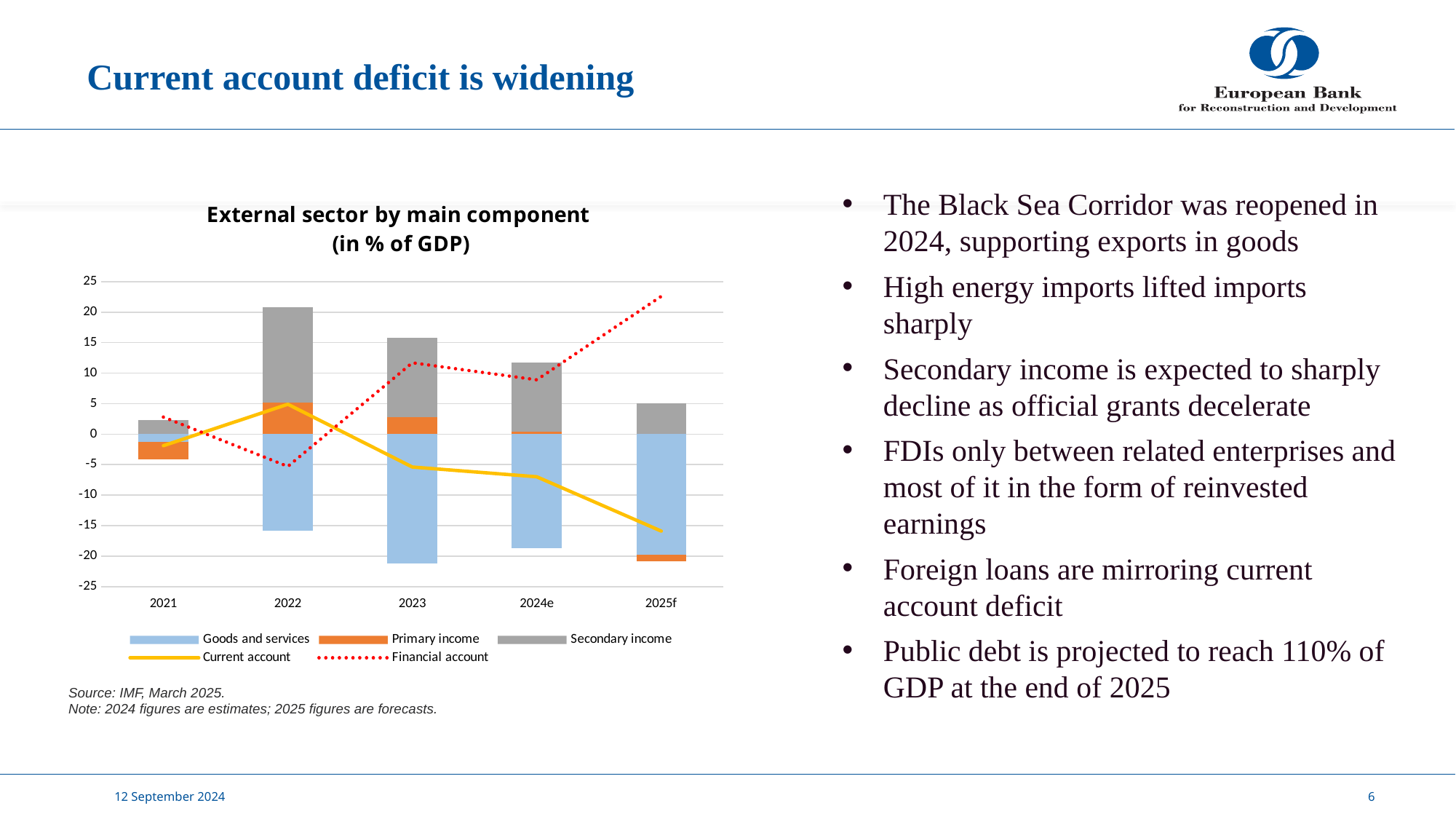
In which year does the Financial account line reach its highest value? 2025f Is the Goods and services value for 2023 greater or less than -15? less In which year is the Secondary income bar the largest? 2022 How many years are shown on the x axis of the chart? 5 In which year is the Current account line at its lowest value? 2025f Is the Financial account value for 2025f greater or less than 20? greater Does the Current account line rise or fall from 2022 to 2025f? fall Is the Current account value for 2025f greater or less than -10? less What kind of chart is shown on the slide? Stacked bar chart with line series How many series does the chart legend list? 5 Which is larger, the Secondary income value for 2022 or for 2025f? 2022 What is the title of the chart? External sector by main component (in % of GDP)